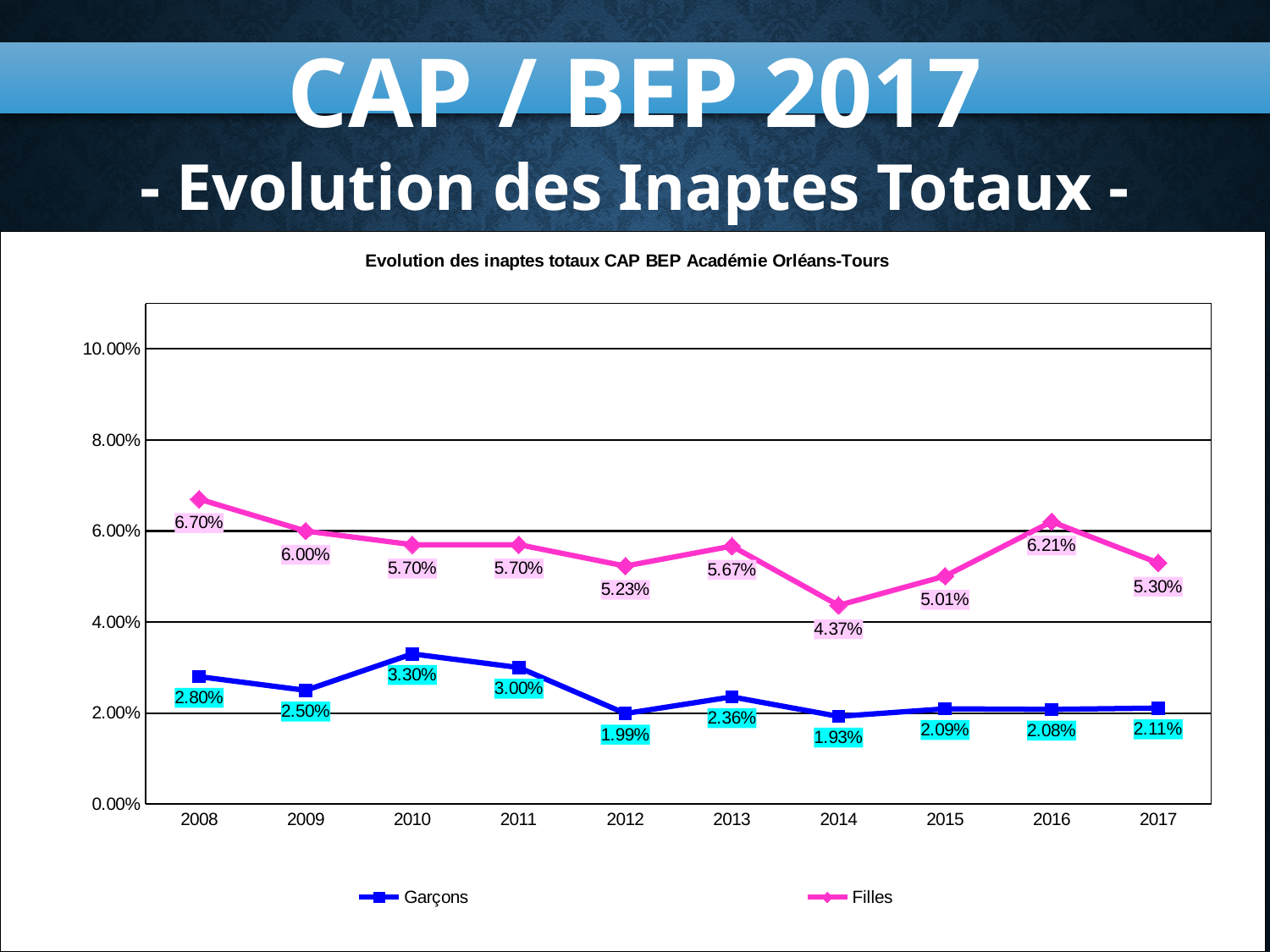
Does the Filles value rise or fall from 2008 to 2012? Fall Which series has the larger value in 2016, Garçons or Filles? Filles What is the value for Garçons in 2014? 1.93% In which year is the Garçons value highest? 2010 In which year is the Filles value lowest? 2014 How many series does the legend list? 2 How many years are shown on the x axis? 10 What kind of chart is shown on the slide? Line chart What is the value for Filles in 2008? 6.70% What is the title of the chart? Evolution des inaptes totaux CAP BEP Académie Orléans-Tours What is the value for Garçons in 2010? 3.30% What is the difference between the Filles and Garçons values in 2017? 3.19%